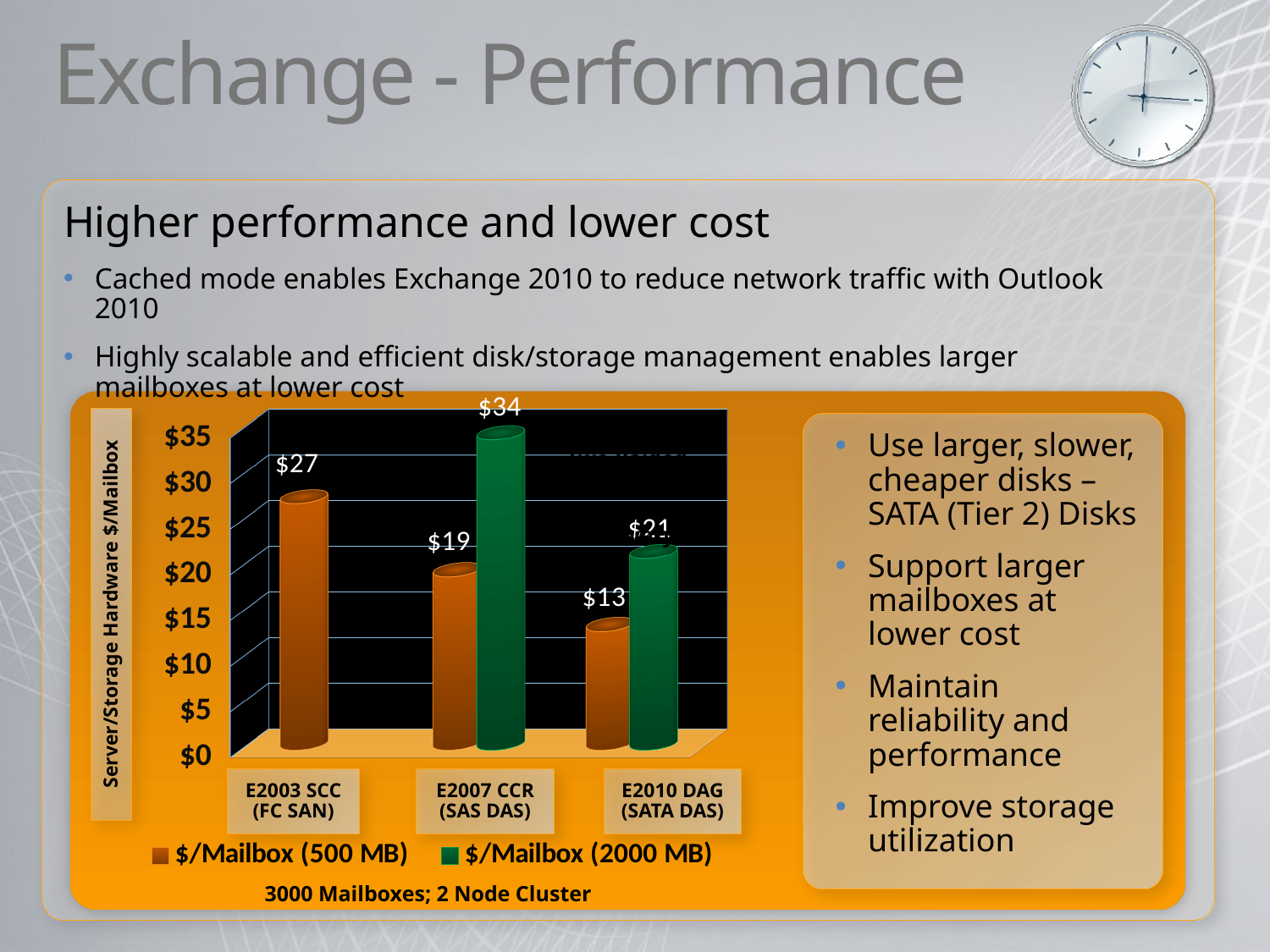
Is the $/Mailbox (2000 MB) value for E2007 CCR (SAS DAS) greater or less than $30? greater Which category has the highest $/Mailbox (500 MB) value? E2003 SCC (FC SAN) What is the difference between the $/Mailbox (500 MB) values for E2003 SCC (FC SAN) and E2010 DAG (SATA DAS)? $14 What is the label of the vertical axis of the chart? Server/Storage Hardware $/Mailbox How many series does the chart legend list? 2 What is the $/Mailbox (2000 MB) value for E2007 CCR (SAS DAS)? $34 How many categories are shown on the x axis of the chart? 3 Which is larger: the $/Mailbox (2000 MB) value for E2007 CCR (SAS DAS) or for E2010 DAG (SATA DAS)? E2007 CCR (SAS DAS) What is the $/Mailbox (500 MB) value for E2007 CCR (SAS DAS)? $19 What is the $/Mailbox (500 MB) value for E2003 SCC (FC SAN)? $27 Which category has the lowest $/Mailbox (500 MB) value? E2010 DAG (SATA DAS) What is the $/Mailbox (500 MB) value for E2010 DAG (SATA DAS)? $13